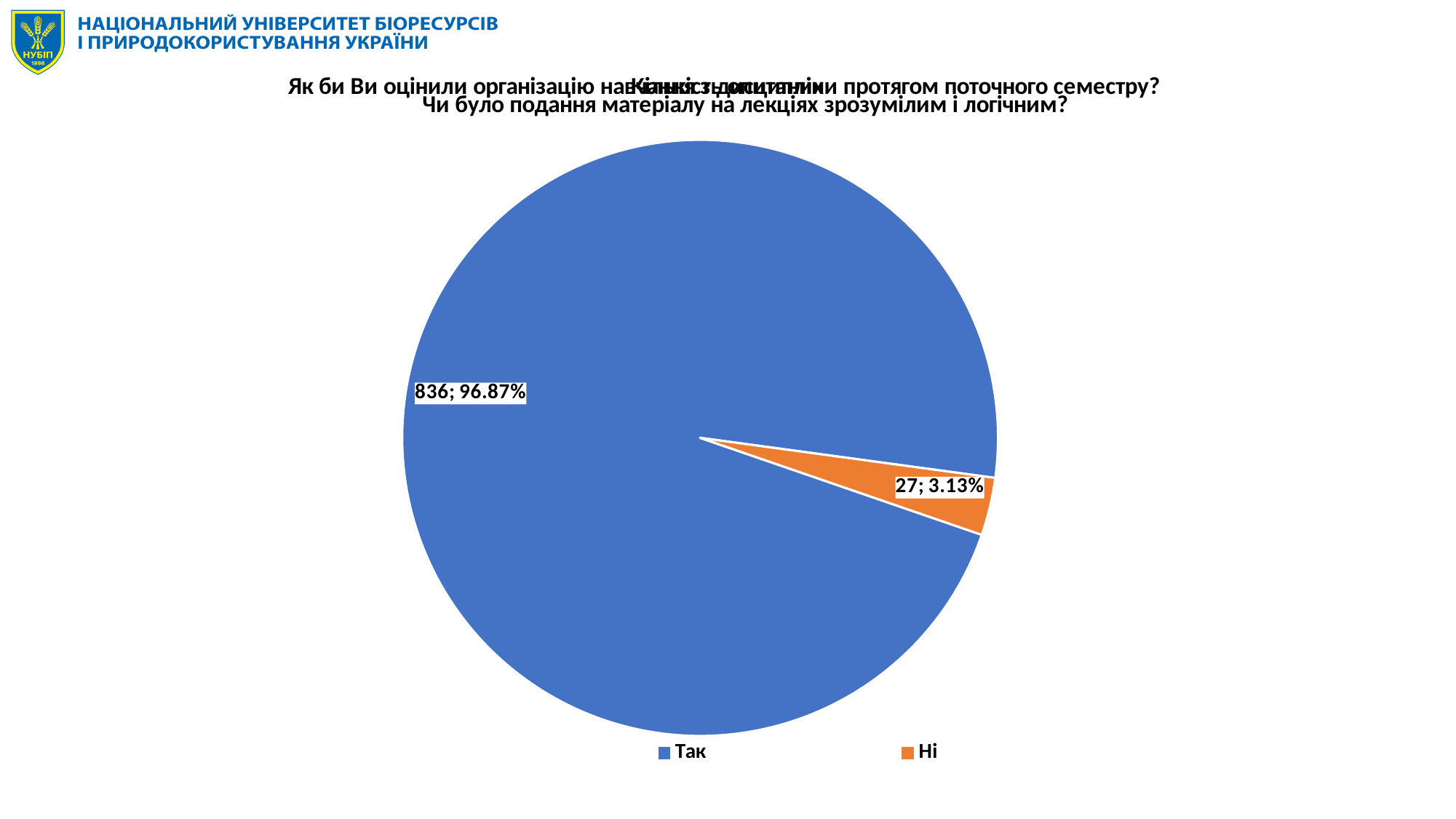
Which slice is the largest in the pie chart? Так What is the count shown for the "Так" slice? 836 Which slice is the smallest in the pie chart? Ні How many entries does the legend of the pie chart list? 2 Which is larger, the count for "Так" or the count for "Ні"? Так What kind of chart is shown on the slide? pie chart What is the difference between the counts for "Так" and "Ні"? 809 How many slices does the pie chart have? 2 What percentage share does the "Так" slice have? 96.87% What percentage share does the "Ні" slice have? 3.13% What is the count shown for the "Ні" slice? 27 What colour is the "Ні" slice in the pie chart? orange